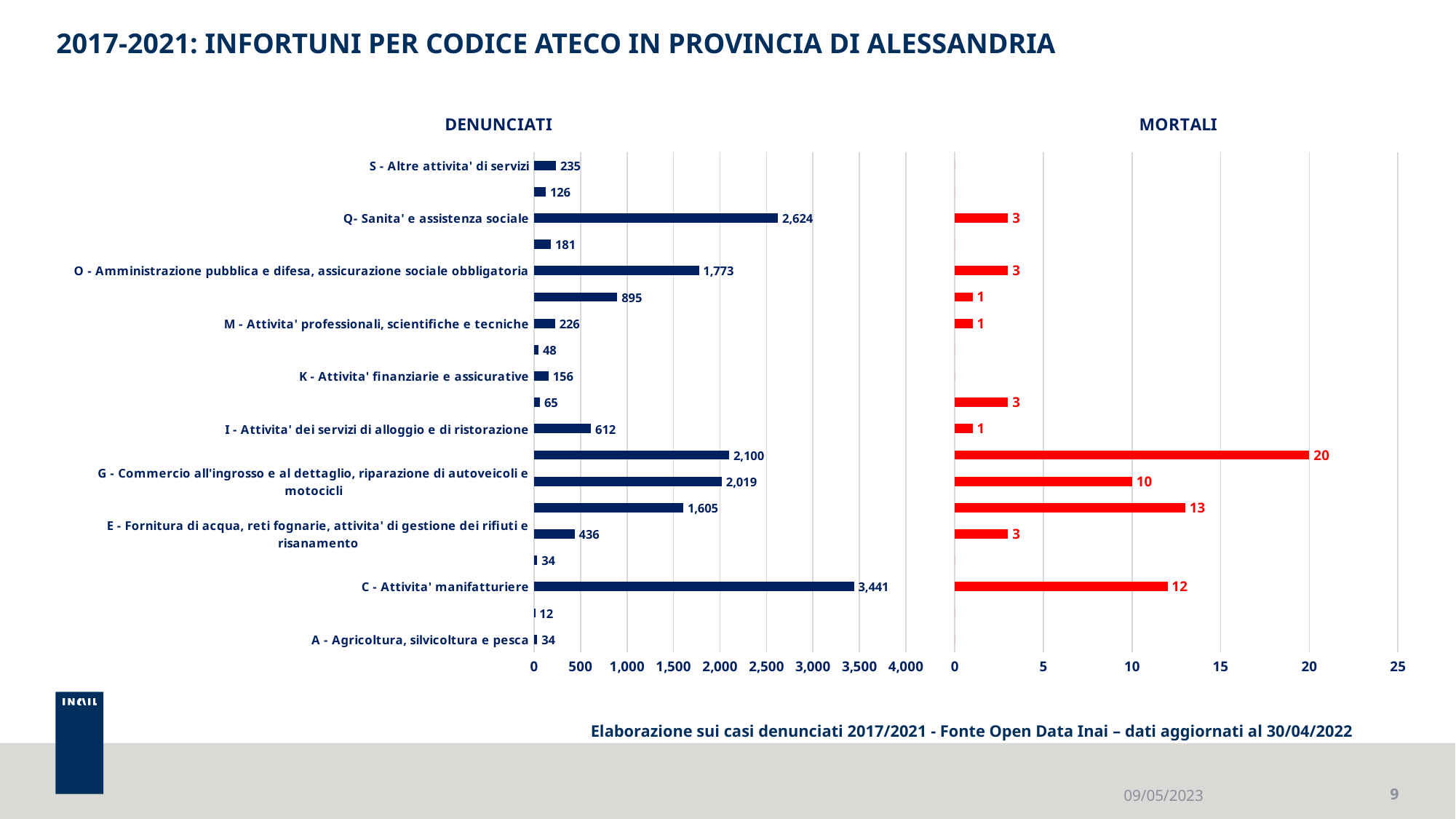
In the MORTALI chart, is the value for E - Fornitura di acqua, reti fognarie greater or less than 5? less In the DENUNCIATI chart, what is the difference between C - Attivita' manifatturiere and Q- Sanita' e assistenza sociale? 817 In the DENUNCIATI chart, what is the value for Q- Sanita' e assistenza sociale? 2,624 In the DENUNCIATI chart, which is larger: Q- Sanita' e assistenza sociale or O - Amministrazione pubblica e difesa? Q- Sanita' e assistenza sociale In the DENUNCIATI chart, is the value for O - Amministrazione pubblica e difesa greater or less than 1,500? greater In the DENUNCIATI chart, what is the value for C - Attivita' manifatturiere? 3,441 In the MORTALI chart, what is the difference between C - Attivita' manifatturiere and G - Commercio all'ingrosso e al dettaglio? 2 What colour are the bars in the MORTALI chart? red In the DENUNCIATI chart, which labelled category has the highest value? C - Attivita' manifatturiere In the MORTALI chart, what is the value for C - Attivita' manifatturiere? 12 What kind of chart is the DENUNCIATI chart? bar chart In the MORTALI chart, what is the value for G - Commercio all'ingrosso e al dettaglio, riparazione di autoveicoli e motocicli? 10